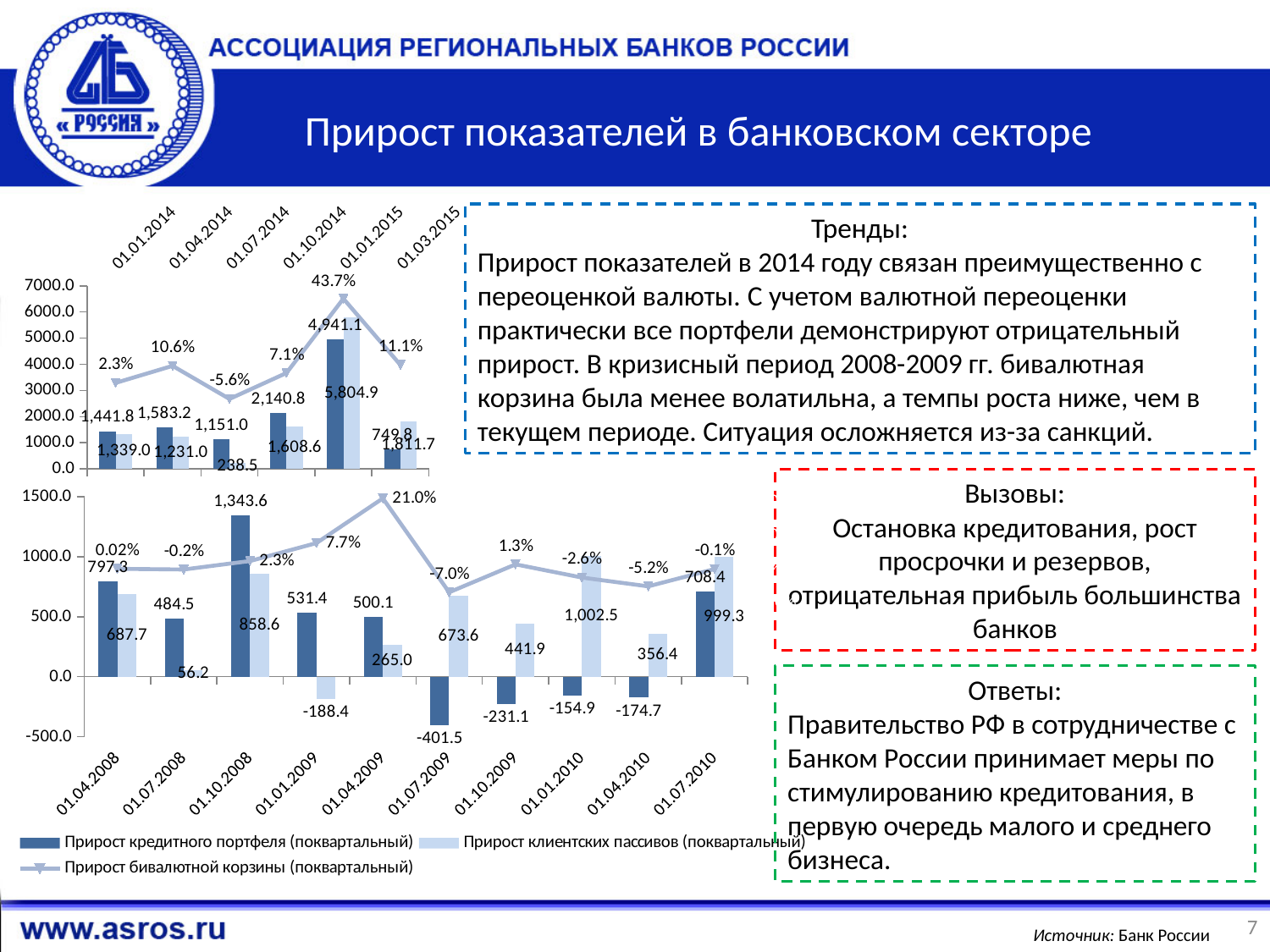
In the top chart, what is the value of the credit portfolio growth (Прирост кредитного портфеля) for 01.01.2015? 4,941.1 In the bottom chart, what is the client liabilities growth for 01.01.2010? 1,002.5 What kind of chart is the top chart? Combined bar and line chart How many series does the legend list? 3 How many dates are shown on the x axis of the bottom chart? 10 In the bottom chart, what is the credit portfolio growth for 01.07.2009? -401.5 In the top chart, which date has the highest client liabilities growth (Прирост клиентских пассивов)? 01.01.2015 In the bottom chart, which date has the highest bi-currency basket growth? 01.04.2009 In the top chart, what is the bi-currency basket growth (Прирост бивалютной корзины) for 01.04.2014? 10.6% In the bottom chart, which is larger for 01.10.2008: the credit portfolio growth or the client liabilities growth? Credit portfolio growth (1,343.6) In the top chart, what is the difference between the client liabilities growth and the credit portfolio growth for 01.01.2015? 863.8 In the bottom chart, which date has the lowest credit portfolio growth? 01.07.2009